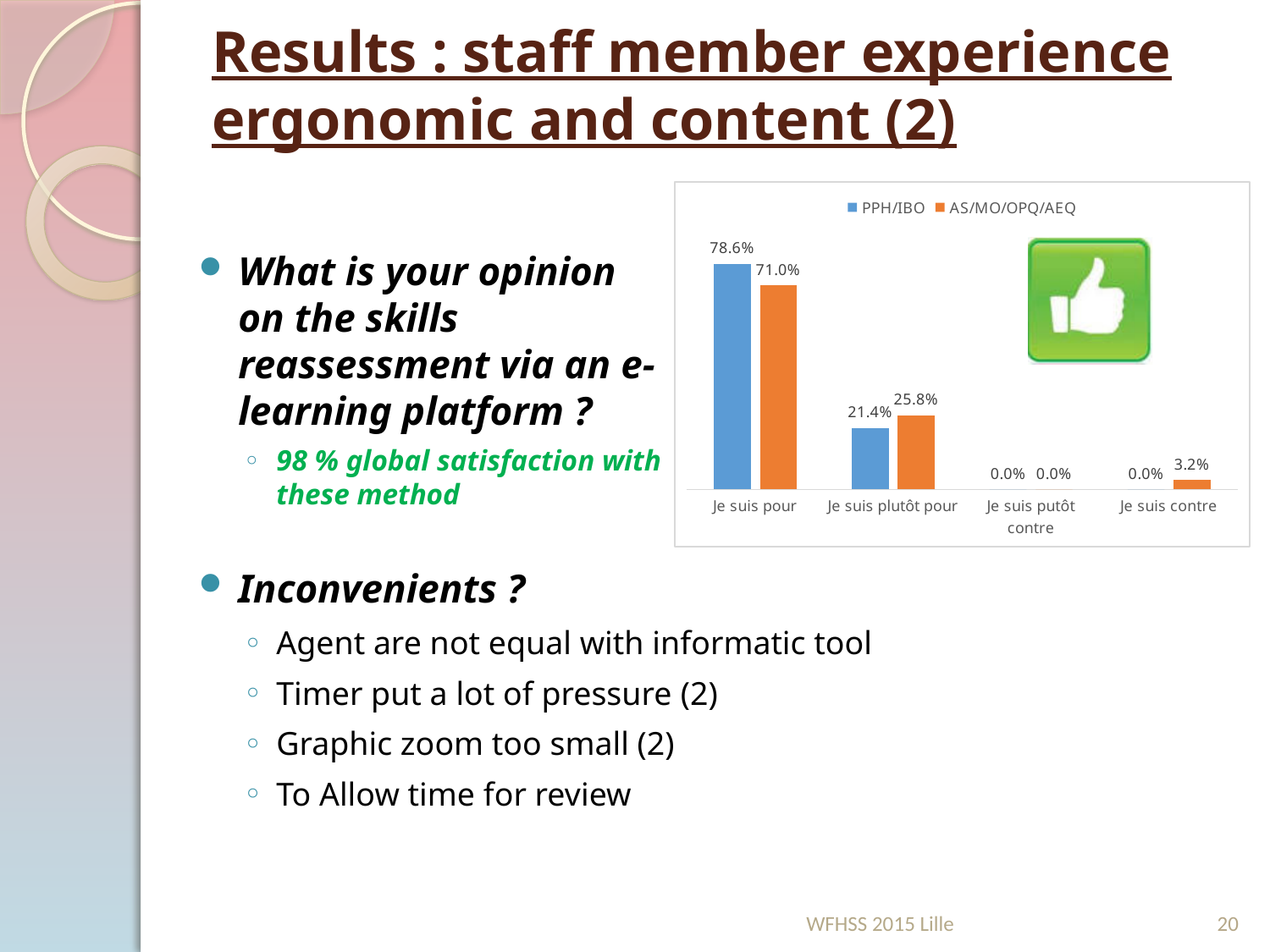
What kind of chart is shown on the slide? Bar chart What is the value for AS/MO/OPQ/AEQ in the 'Je suis pour' category? 71.0% What is the difference between the PPH/IBO and AS/MO/OPQ/AEQ values in the 'Je suis pour' category? 7.6% What is the value for PPH/IBO in the 'Je suis plutôt pour' category? 21.4% What is the value for PPH/IBO in the 'Je suis pour' category? 78.6% Which category has the highest value for PPH/IBO? Je suis pour In the 'Je suis plutôt pour' category, which series has the larger value, PPH/IBO or AS/MO/OPQ/AEQ? AS/MO/OPQ/AEQ How many categories are shown on the x axis of the chart? 4 What are the two series names listed in the chart legend? PPH/IBO and AS/MO/OPQ/AEQ How many series does the chart legend list? 2 What is the difference between the AS/MO/OPQ/AEQ and PPH/IBO values in the 'Je suis plutôt pour' category? 4.4% What is the value for AS/MO/OPQ/AEQ in the 'Je suis contre' category? 3.2%